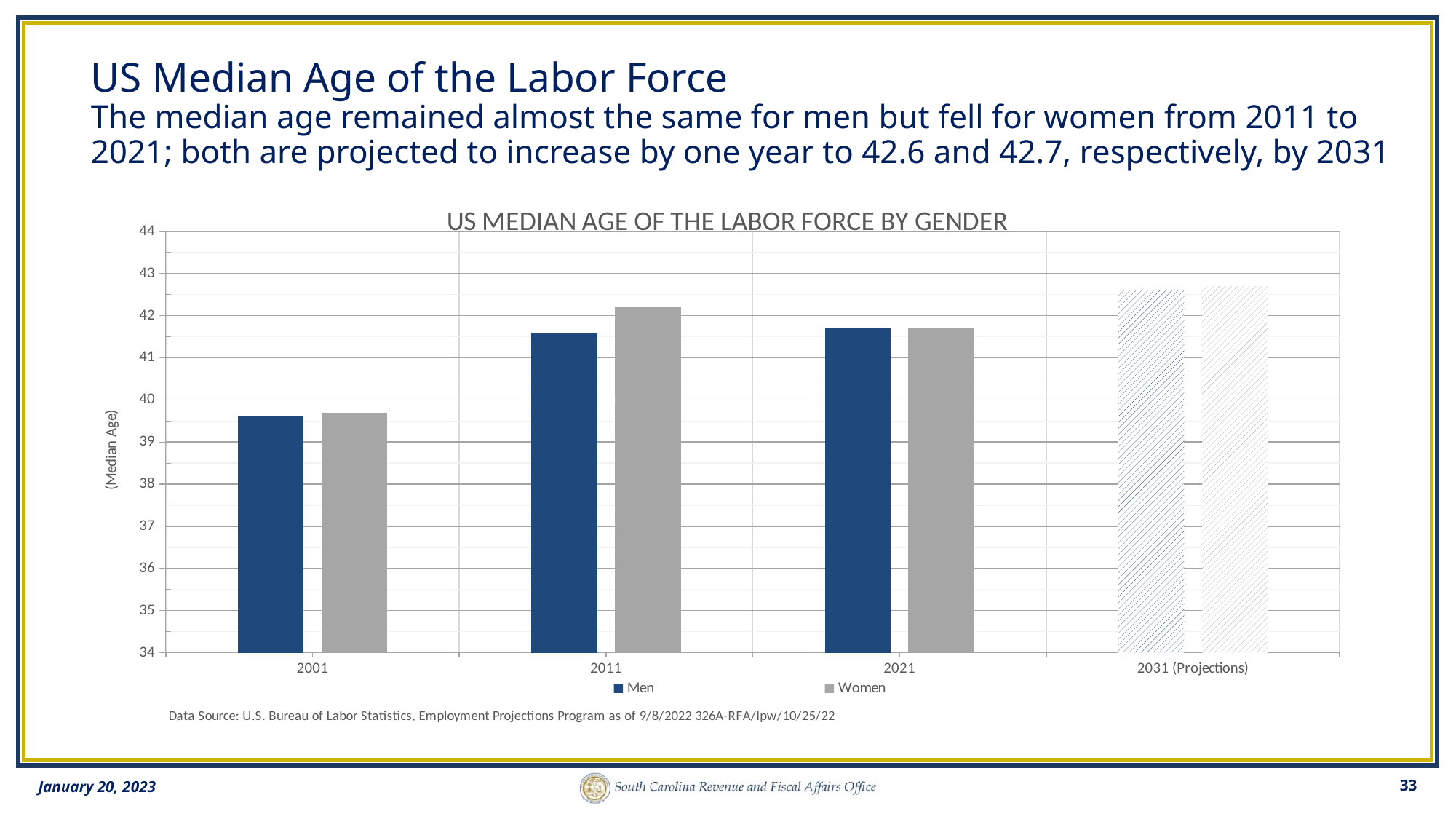
For Men, which year has the lowest median age? 2001 Do the median age values for Men rise or fall from 2001 to 2031 (Projections)? rise How many year categories are shown on the x axis? 4 What is the title of the chart? US MEDIAN AGE OF THE LABOR FORCE BY GENDER Which series is shown in dark blue in the legend? Men How many series does the legend list? 2 What type of chart is shown on the slide? Bar chart Is the median age for Men in 2011 greater or less than 42? less In 2011, which group had the higher median age, Men or Women? Women For Women, which year has the highest median age? 2031 (Projections) Is the median age for Women in 2011 greater or less than 42? greater Is the median age for Men in 2001 greater or less than 40? less